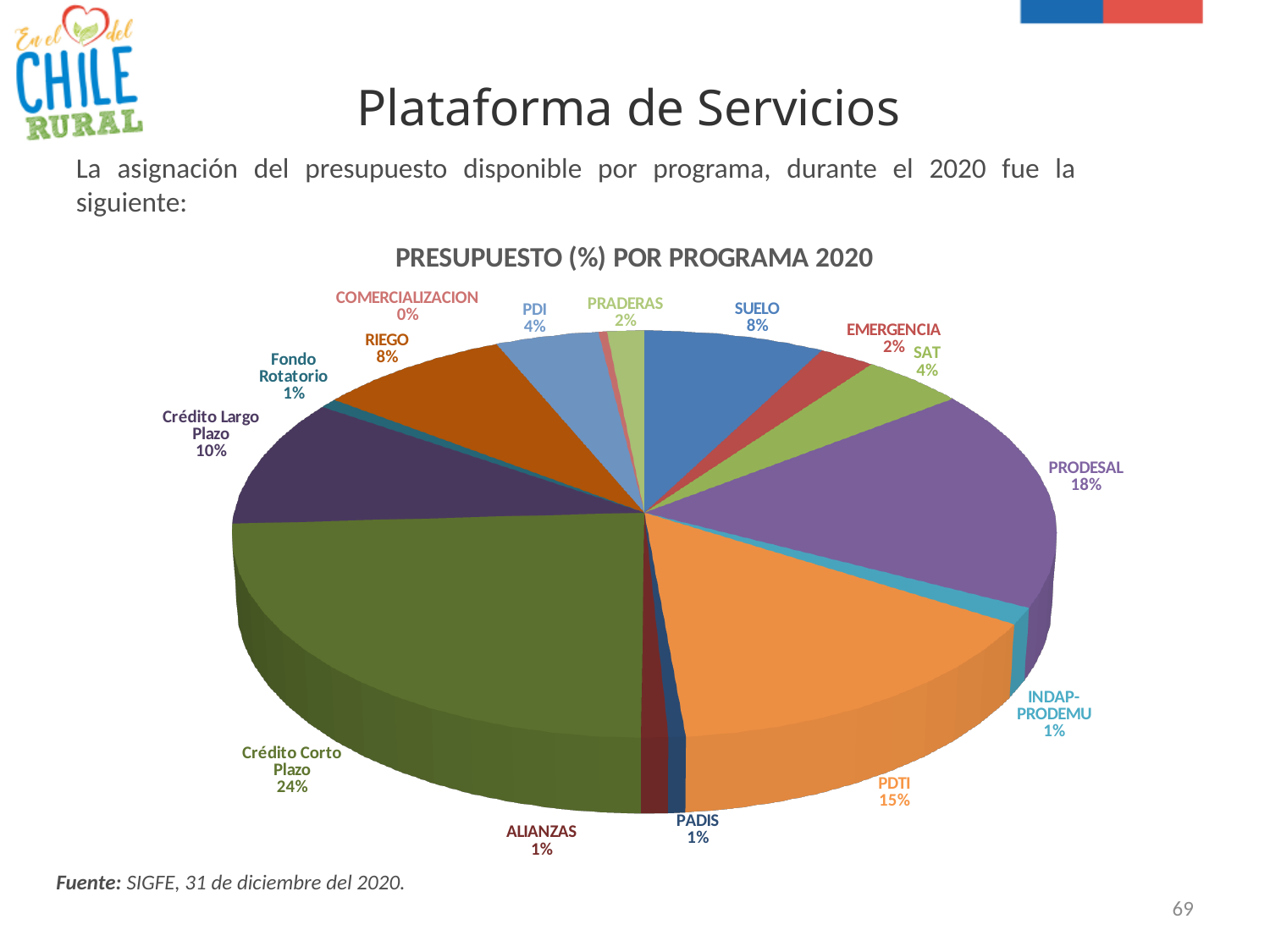
What percentage of the budget is allocated to PRODESAL? 18% What type of chart is shown on the slide? Pie chart What share does Crédito Largo Plazo have in the pie chart? 10% How many programs (slices) are shown in the pie chart? 15 What is the title of the chart? PRESUPUESTO (%) POR PROGRAMA 2020 Which program has the largest share of the 2020 budget? Crédito Corto Plazo Which program has the smallest share of the 2020 budget? COMERCIALIZACION Which has a larger share of the budget, RIEGO or SAT? RIEGO What percentage is shown for SUELO? 8% What is the difference in percentage points between Crédito Corto Plazo and PDTI? 9% What percentage of the budget is allocated to PDTI? 15% What is the combined share of PRODESAL and PDTI? 33%